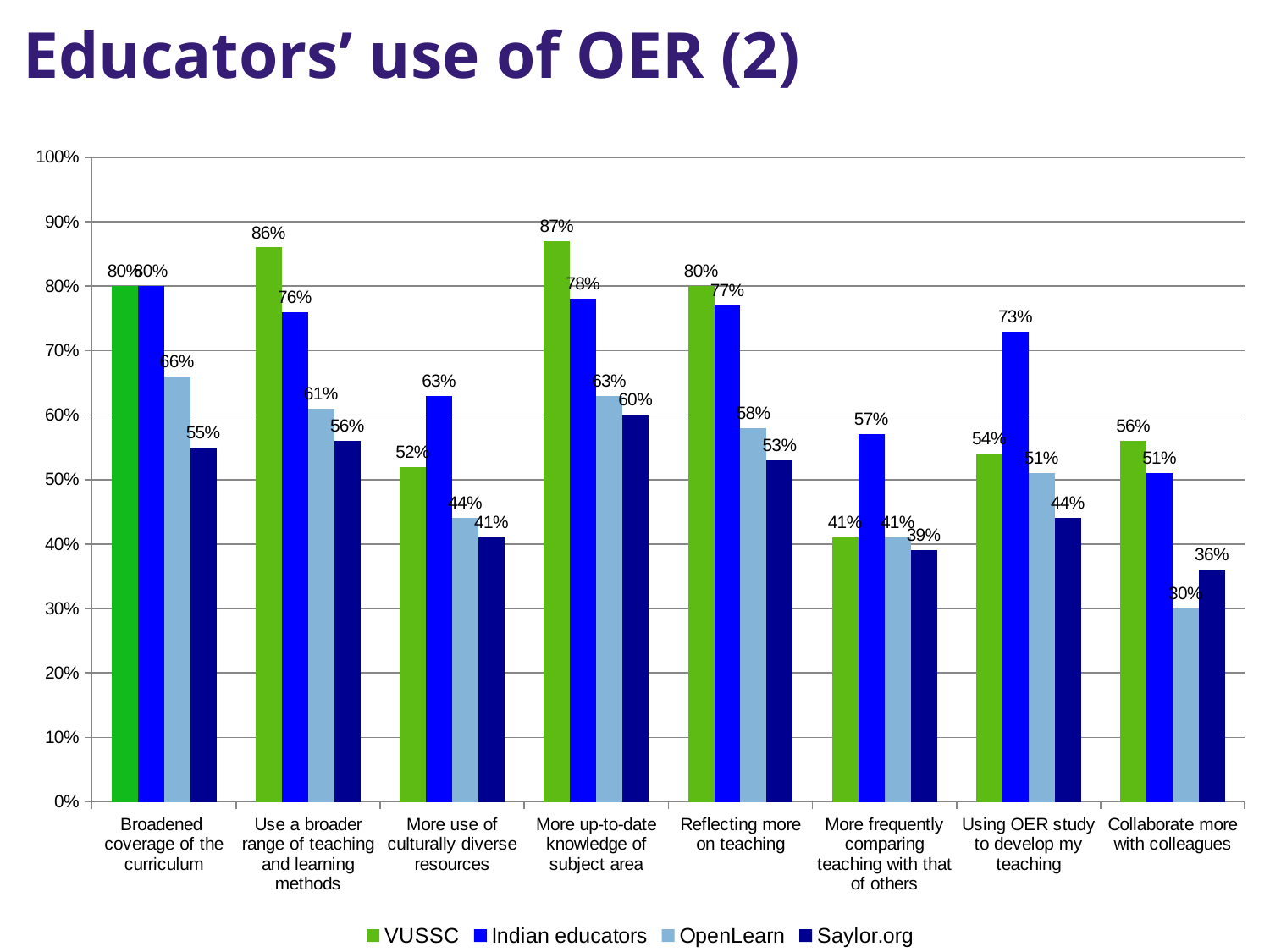
For 'More use of culturally diverse resources', which is larger: the VUSSC value or the Indian educators value? Indian educators Which category has the highest VUSSC value? More up-to-date knowledge of subject area Which category has the lowest OpenLearn value? Collaborate more with colleagues What is the difference between the VUSSC and Saylor.org values for 'Use a broader range of teaching and learning methods'? 30% What is the VUSSC value for 'More up-to-date knowledge of subject area'? 87% Which series is shown in green in the legend? VUSSC How many series does the legend list? 4 What is the Indian educators value for 'Using OER study to develop my teaching'? 73% What is the OpenLearn value for 'Collaborate more with colleagues'? 30% How many categories are shown on the x axis? 8 What type of chart is shown on the slide? Bar chart What is the Saylor.org value for 'Broadened coverage of the curriculum'? 55%